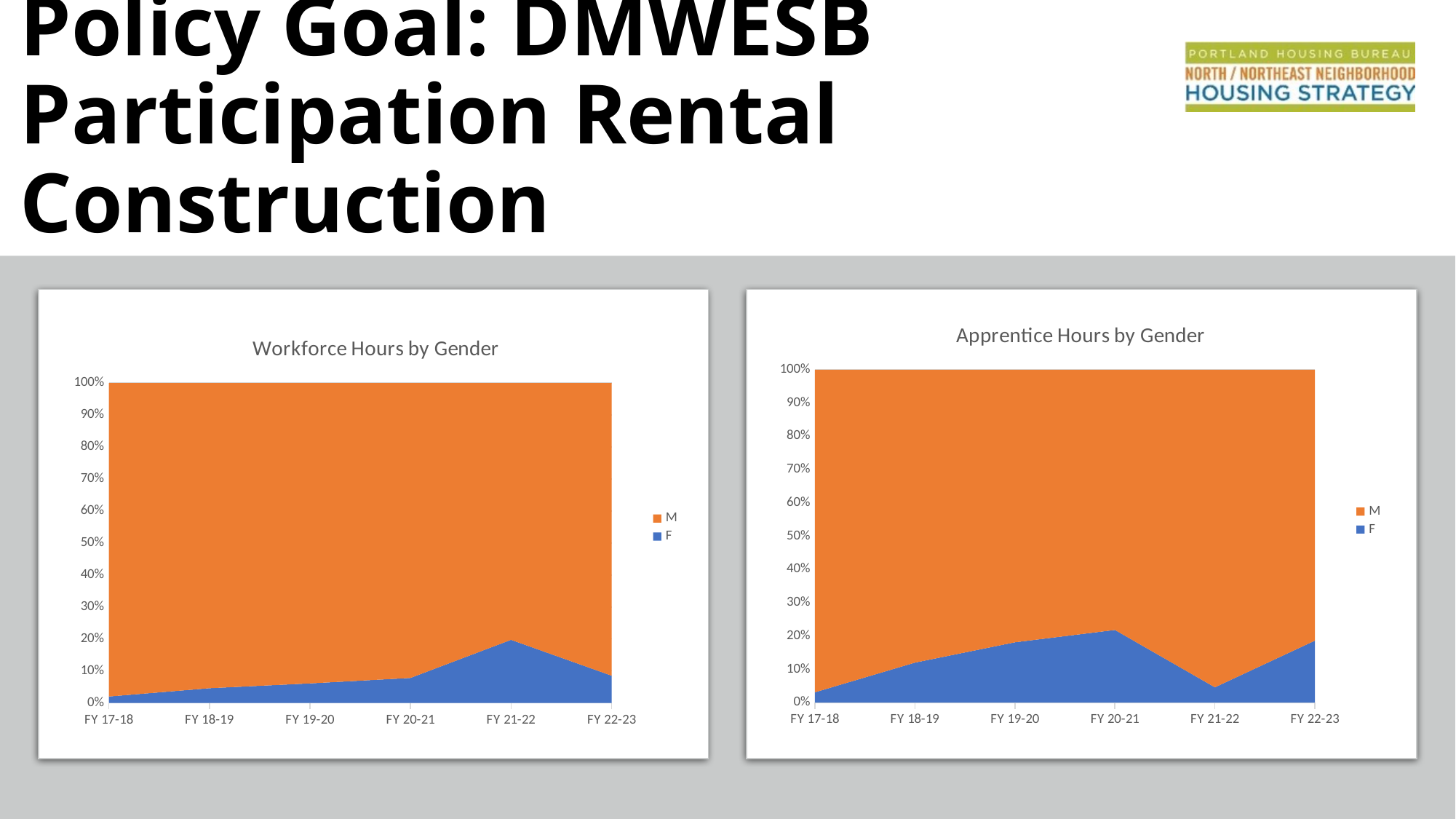
In the 'Workforce Hours by Gender' chart, is the F share for FY 18-19 greater or less than 10%? less In the 'Workforce Hours by Gender' chart, is the F share for FY 21-22 greater or less than 10%? greater In the 'Workforce Hours by Gender' chart, which fiscal year has the highest share for F? FY 21-22 In the 'Workforce Hours by Gender' chart, which fiscal year has the lowest share for F? FY 17-18 In the 'Apprentice Hours by Gender' chart, is the F share for FY 21-22 greater or less than 10%? less What colour represents the M series in the 'Apprentice Hours by Gender' chart? Orange In the 'Workforce Hours by Gender' chart, does the F share rise or fall from FY 17-18 to FY 21-22? Rise What kind of chart is the 'Workforce Hours by Gender' chart? Area chart How many fiscal years are shown on the x axis of the 'Apprentice Hours by Gender' chart? 6 How many series does the legend of the 'Workforce Hours by Gender' chart list? 2 In the 'Apprentice Hours by Gender' chart, which is larger, the F share for FY 20-21 or for FY 21-22? FY 20-21